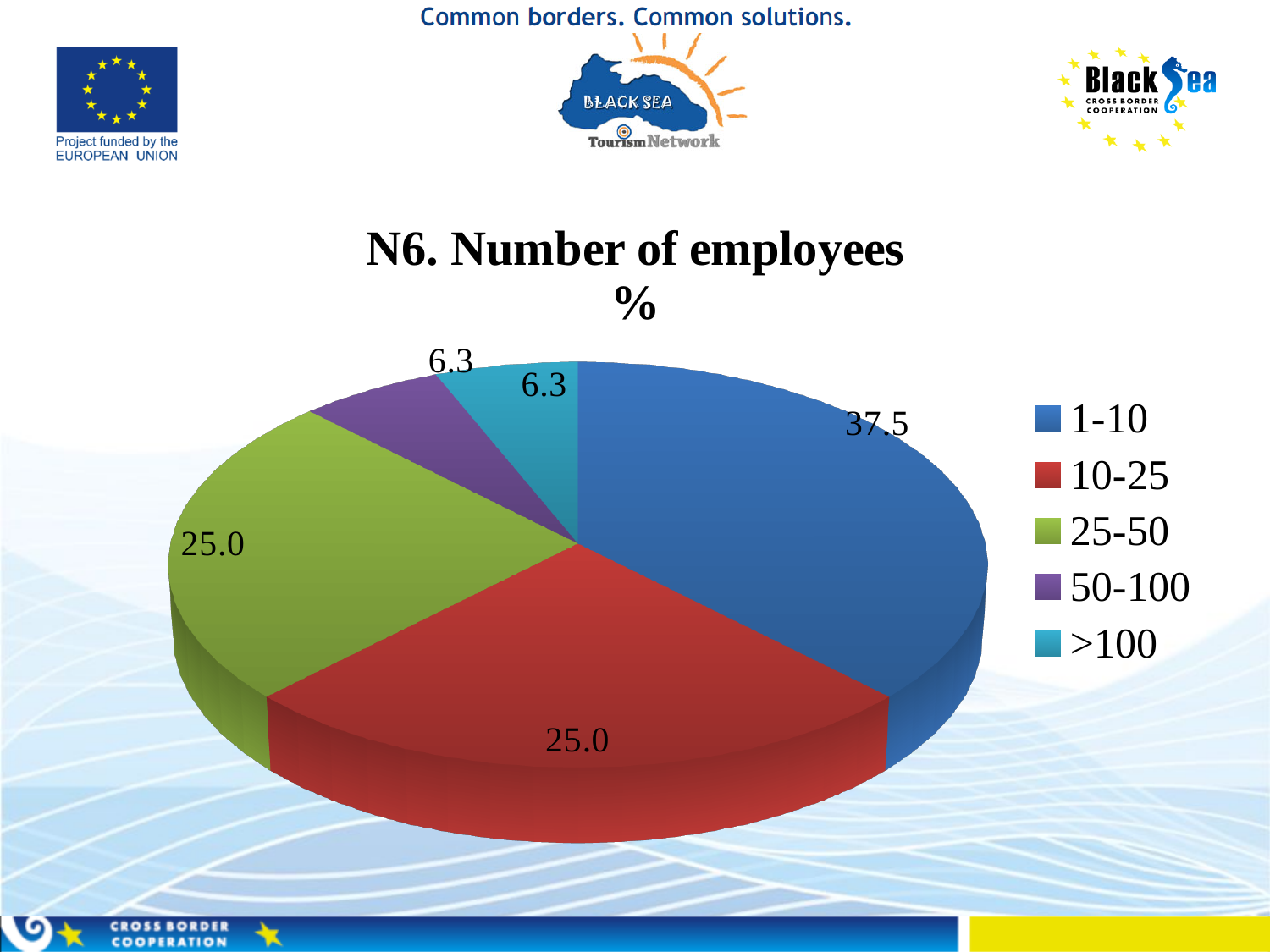
Which category has the largest slice of the pie? 1-10 What is the value shown for the 50-100 slice? 6.3 What is the difference between the value for 1-10 and the value for 25-50? 12.5 Which is larger, the value for 1-10 or the value for 10-25? 1-10 What is the value shown for the 25-50 slice? 25.0 What kind of chart is shown on the slide? Pie chart What is the value shown for the >100 slice? 6.3 Which colour represents the 25-50 category in the legend? Green What is the value shown for the 10-25 slice? 25.0 What is the value shown for the 1-10 slice? 37.5 What is the title of the chart? N6. Number of employees % How many categories does the pie chart show? 5